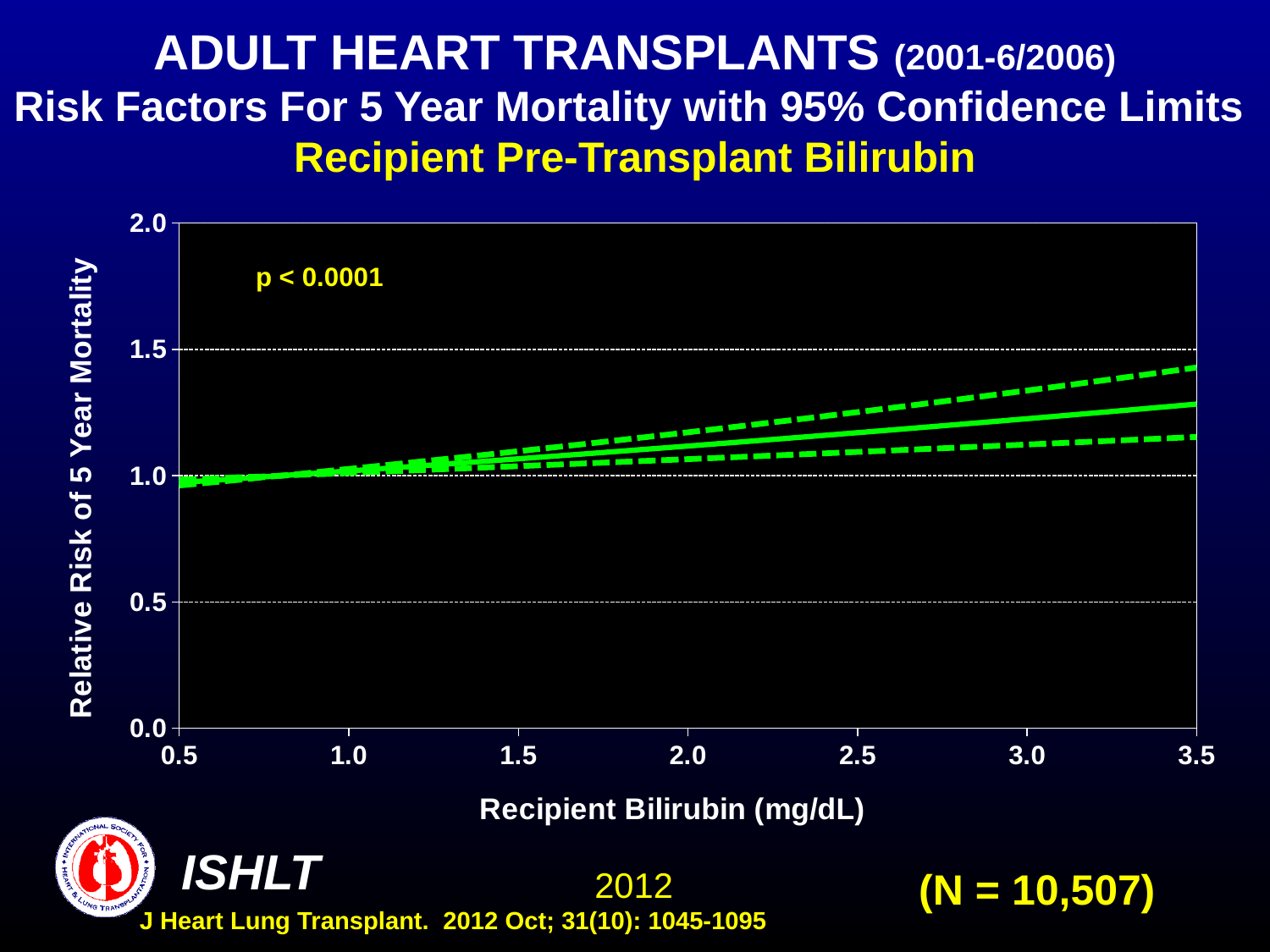
How many lines are plotted on the chart? 3 Is the upper 95% confidence limit (upper dashed line) at a recipient bilirubin of 3.5 mg/dL greater or less than 1.5? less What is the highest value shown on the y axis? 2.0 Is the lower 95% confidence limit (lower dashed line) at a recipient bilirubin of 3.5 mg/dL greater or less than 1.0? greater Is the relative risk of 5 year mortality (solid line) at a recipient bilirubin of 3.5 mg/dL greater or less than 1.5? less What p-value is printed on the chart? p < 0.0001 What kind of chart is shown on the slide? line chart What is the label of the x axis? Recipient Bilirubin (mg/dL) Does the relative risk of 5 year mortality rise or fall as recipient bilirubin increases from 0.5 to 3.5 mg/dL? rise